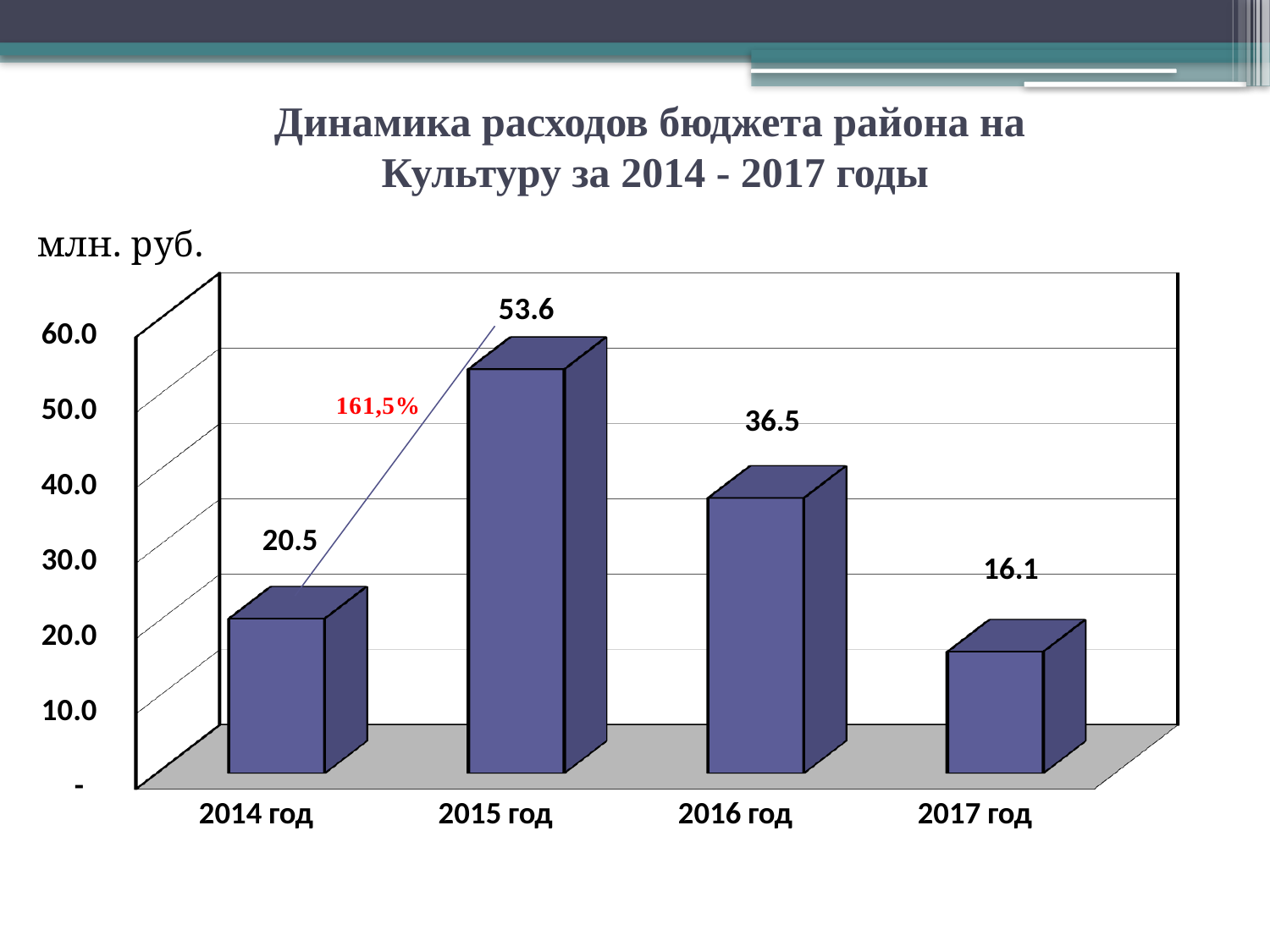
What percentage is written in red next to the line between the 2014 and 2015 bars? 161,5% Which is larger, the value for 2016 год or the value for 2014 год? 2016 год What is the difference between the values for 2016 год and 2017 год? 20.4 Which year has the highest value? 2015 год What is the value for 2017 год? 16.1 Which year has the lowest value? 2017 год What is the value for 2015 год? 53.6 What is the value for 2014 год? 20.5 How many years are shown on the chart? 4 What is the difference between the values for 2015 год and 2014 год? 33.1 What is the value for 2016 год? 36.5 What kind of chart is this? bar chart